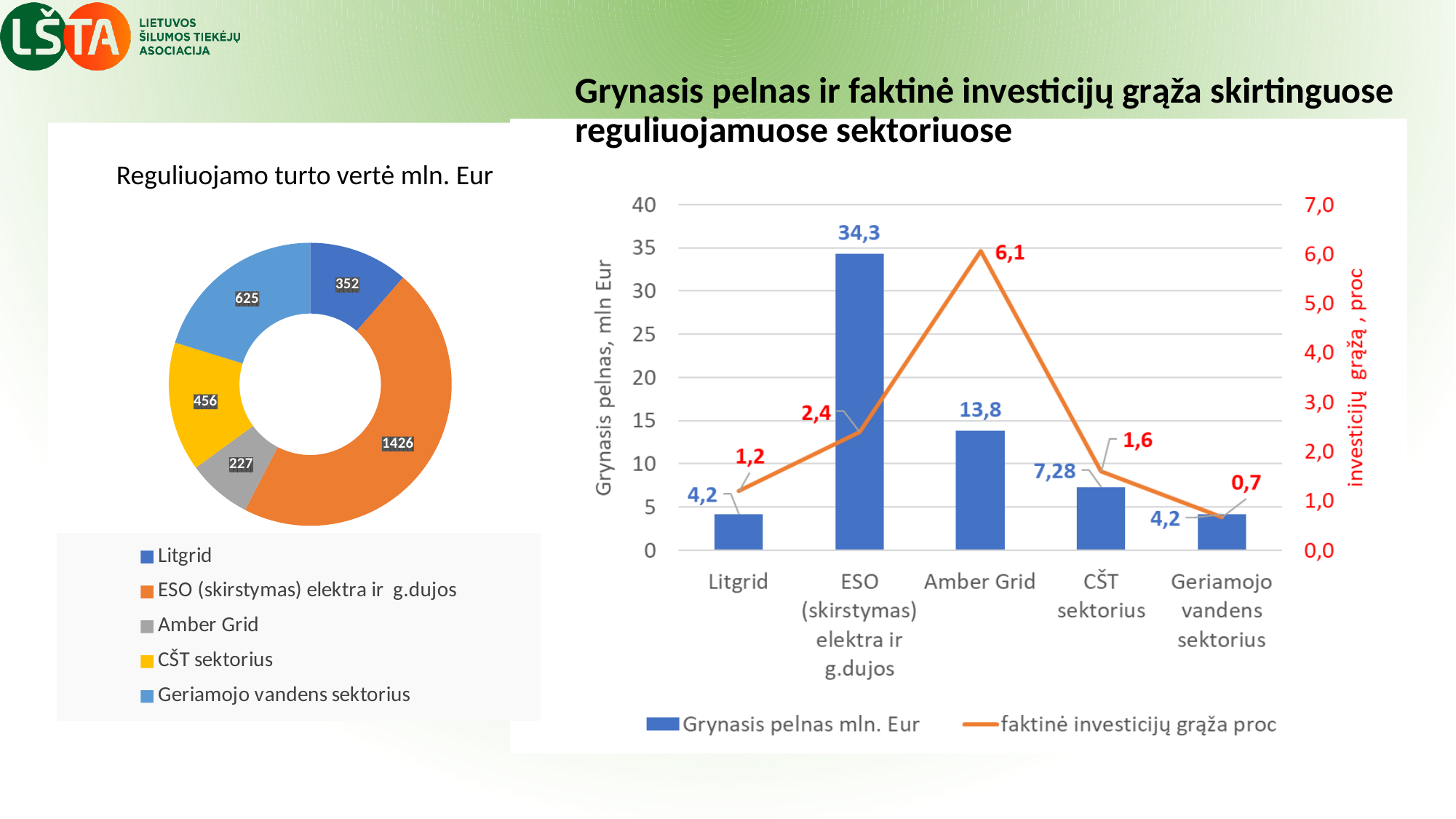
In the doughnut chart 'Reguliuojamo turto vertė mln. Eur', what is the difference between the values for Geriamojo vandens sektorius and Litgrid? 273 In the doughnut chart 'Reguliuojamo turto vertė mln. Eur', what is the value for CŠT sektorius? 456 In the doughnut chart 'Reguliuojamo turto vertė mln. Eur', which category has the largest value? ESO (skirstymas) elektra ir g.dujos In the doughnut chart 'Reguliuojamo turto vertė mln. Eur', which category has the smallest value? Amber Grid In the chart 'Grynasis pelnas ir faktinė investicijų grąža skirtinguose reguliuojamuose sektoriuose', which category has the lowest faktinė investicijų grąža proc? Geriamojo vandens sektorius In the chart 'Grynasis pelnas ir faktinė investicijų grąža skirtinguose reguliuojamuose sektoriuose', which has the larger Grynasis pelnas mln. Eur: ESO (skirstymas) elektra ir g.dujos or Amber Grid? ESO (skirstymas) elektra ir g.dujos How many categories does the doughnut chart 'Reguliuojamo turto vertė mln. Eur' show? 5 In the chart 'Grynasis pelnas ir faktinė investicijų grąža skirtinguose reguliuojamuose sektoriuose', which category has the highest faktinė investicijų grąža proc? Amber Grid In the chart 'Grynasis pelnas ir faktinė investicijų grąža skirtinguose reguliuojamuose sektoriuose', what is the faktinė investicijų grąža proc value for CŠT sektorius? 1,6 How many series does the legend of the chart 'Grynasis pelnas ir faktinė investicijų grąža skirtinguose reguliuojamuose sektoriuose' list? 2 In the chart 'Grynasis pelnas ir faktinė investicijų grąža skirtinguose reguliuojamuose sektoriuose', what is the Grynasis pelnas mln. Eur value for Amber Grid? 13,8 What kind of chart is 'Reguliuojamo turto vertė mln. Eur'? Doughnut chart